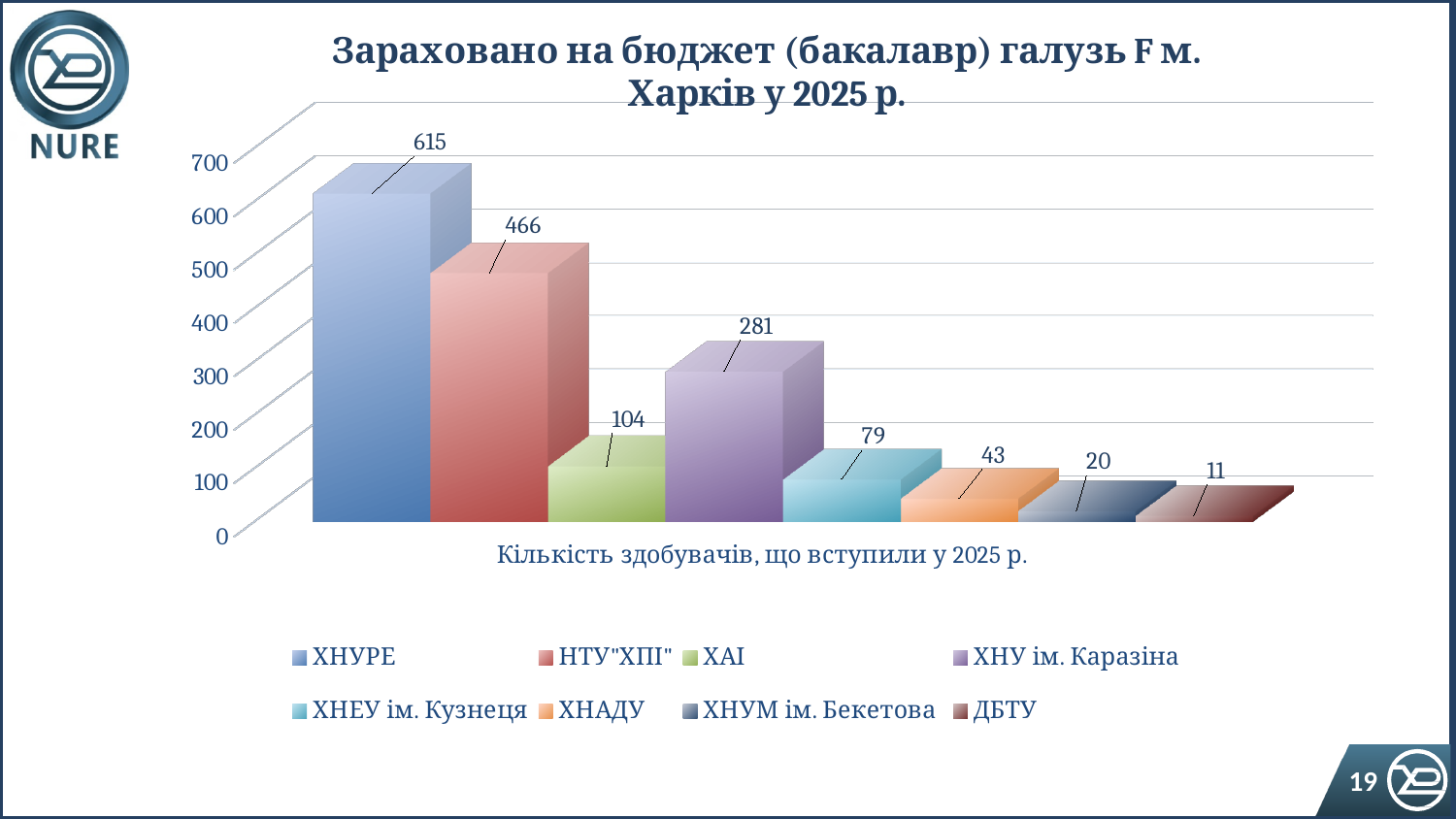
How many series does the legend list? 8 What value is shown for ХНУ ім. Каразіна? 281 Which university has the highest value on the chart? ХНУРЕ What is the title of the chart? Зараховано на бюджет (бакалавр) галузь F м. Харків у 2025 р. Which is larger, the value for ХАІ or the value for ХНЕУ ім. Кузнеця? ХАІ What value is shown for НТУ"ХПІ"? 466 What kind of chart is shown on the slide? Bar chart What is the difference between the values for ХНУ ім. Каразіна and ХАІ? 177 What value is shown for ХНУРЕ? 615 What value is shown for ХНАДУ? 43 What is the difference between the values for ХНУРЕ and НТУ"ХПІ"? 149 Which university has the lowest value on the chart? ДБТУ